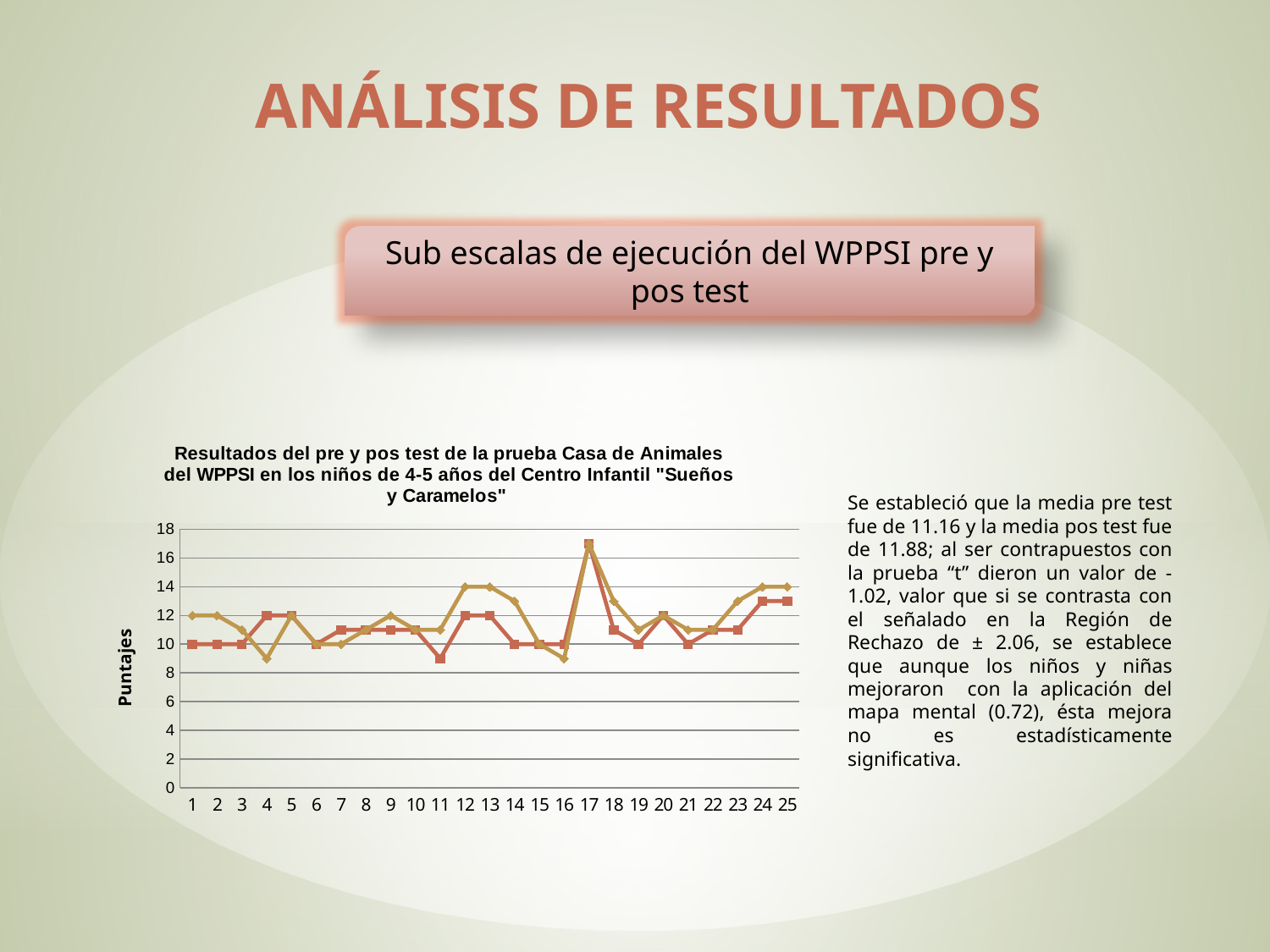
At point 4, which line has the higher value, the red line or the gold line? the red line What is the highest value shown on the vertical axis of the chart? 18 What is the label of the vertical axis of the chart? Puntajes Is the value of the gold line at point 16 greater or less than 10? less What kind of chart is shown on the slide? line chart At which x-axis point does the red line reach its highest value? 17 How many points are plotted along the x axis of the chart? 25 At which x-axis point does the gold line reach its highest value? 17 At point 1, which line has the higher value, the red line or the gold line? the gold line Is the value of the gold line at point 4 greater or less than 10? less At which x-axis point does the red line reach its lowest value? 11 Is the value of the red line at point 17 greater or less than 16? greater